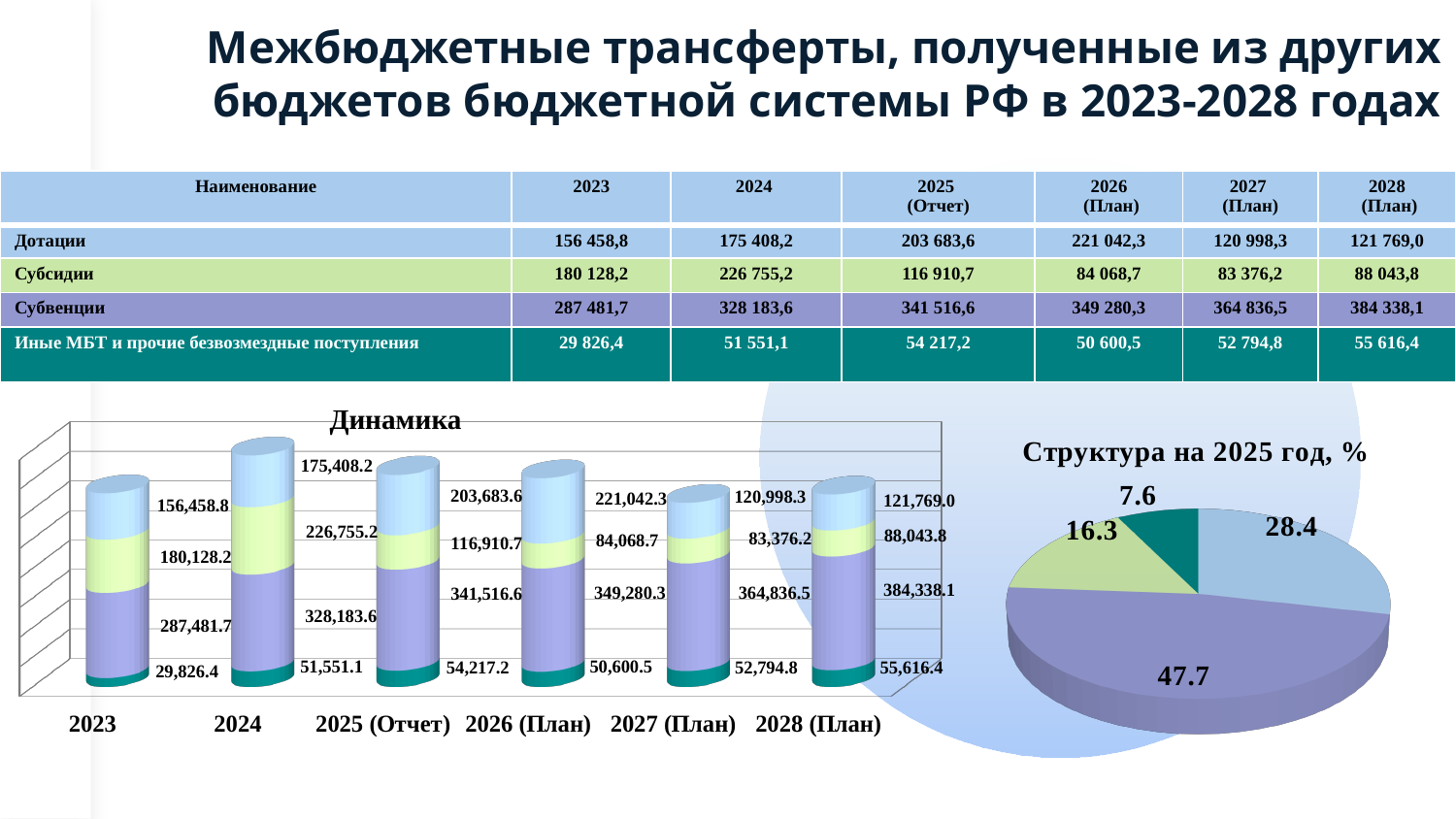
In the "Структура на 2025 год, %" chart, how many slices does the pie have? 4 In the "Динамика" chart, does the purple (Субвенции) segment rise or fall from 2023 to 2028 (План)? rise In the "Динамика" chart, what is the total of the stacked bar for 2023? 653,895.1 In the "Динамика" chart, what is the difference between the purple (Субвенции) segment in 2028 (План) and in 2023? 96,856.4 In the "Динамика" chart, what is the value of the purple (Субвенции) segment for 2028 (План)? 384,338.1 In the "Динамика" chart, which year has the highest value for the light blue (Дотации) segment? 2026 (План) What kind of chart is the "Структура на 2025 год, %" chart? pie chart In the "Структура на 2025 год, %" chart, what is the value of the largest slice? 47.7 In the "Динамика" chart, how many year categories are shown on the x axis? 6 In the "Структура на 2025 год, %" chart, what is the difference between the largest slice and the 28.4 slice? 19.3 In the "Динамика" chart, what is the value of the bottom teal segment for 2023? 29,826.4 What kind of chart is the "Динамика" chart? bar chart